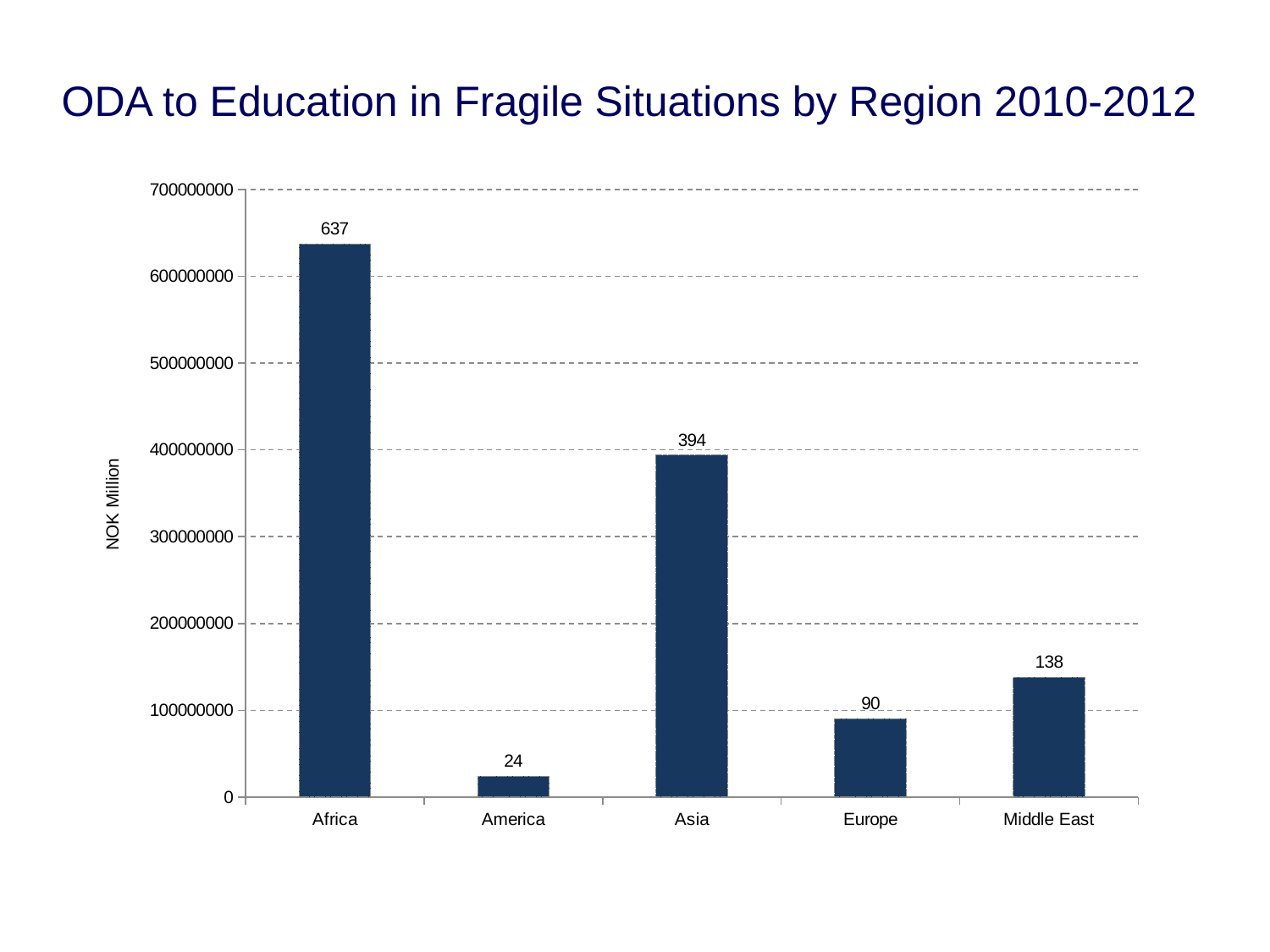
What is the data label shown for Asia? 394 Which region has the lowest value? America Which has the larger value, Europe or Middle East? Middle East Is the value for Asia greater or less than 300000000 on the axis? greater What is the difference between the data labels for Africa and Asia? 243 What is the label on the vertical axis? NOK Million Which region has the highest value? Africa What is the data label shown for Middle East? 138 What is the data label shown for Africa? 637 How many regions are shown on the chart? 5 What is the data label shown for Europe? 90 What kind of chart is shown on the slide? bar chart